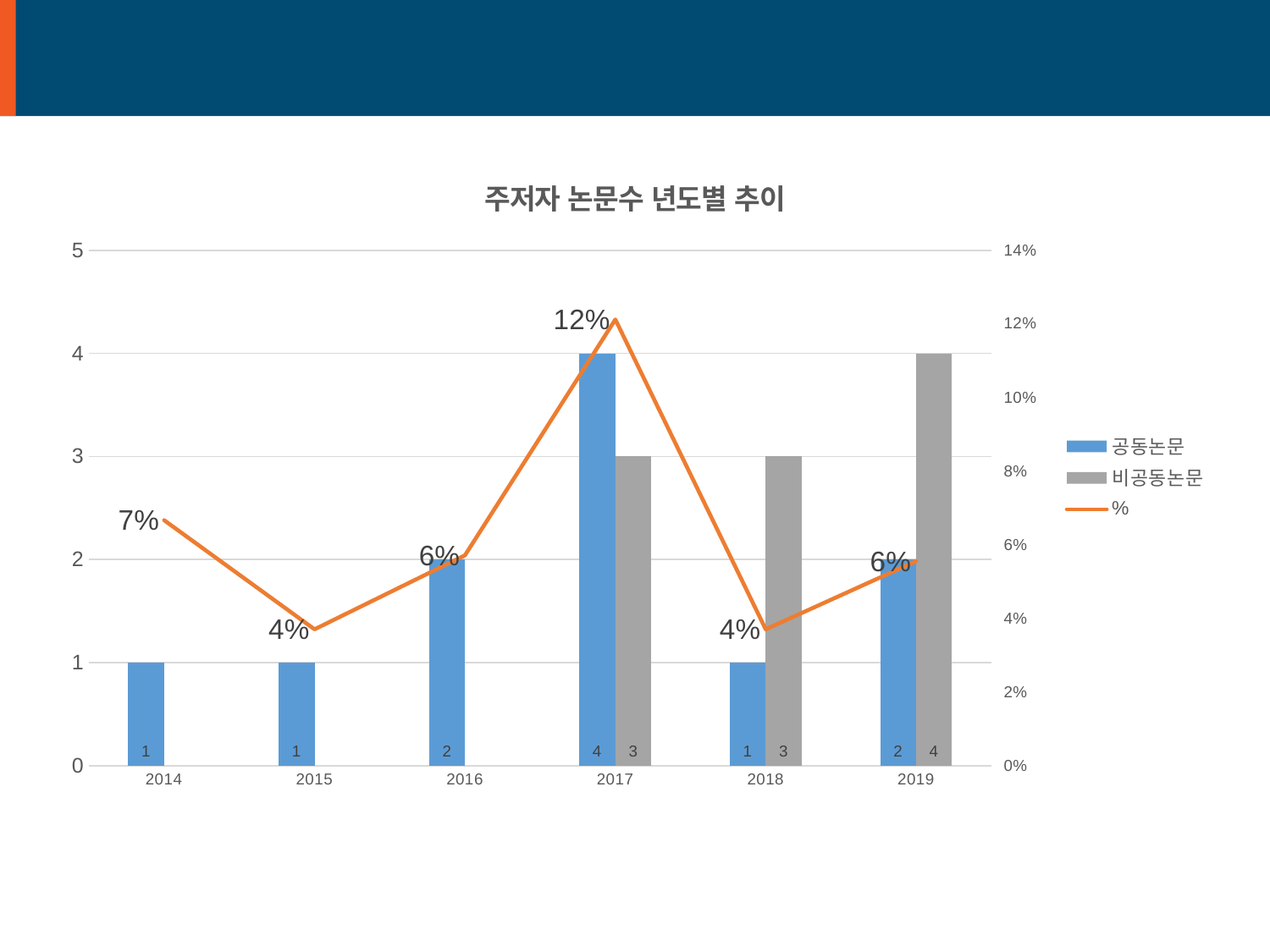
In which year is the 공동논문 bar the tallest? 2017 Which is larger in 2019, 공동논문 or 비공동논문? 비공동논문 What is the difference between the 공동논문 value in 2017 and the 공동논문 value in 2018? 3 What percentage does the % line show for 2014? 7% How many years are shown on the x axis? 6 What is the value of 공동논문 for 2017? 4 Does the % line rise or fall from 2017 to 2018? Fall What kind of chart is this? Combined bar and line chart In which year is the % line at its highest? 2017 What is the title of the chart? 주저자 논문수 년도별 추이 How many series does the legend list? 3 What is the value of 비공동논문 for 2019? 4